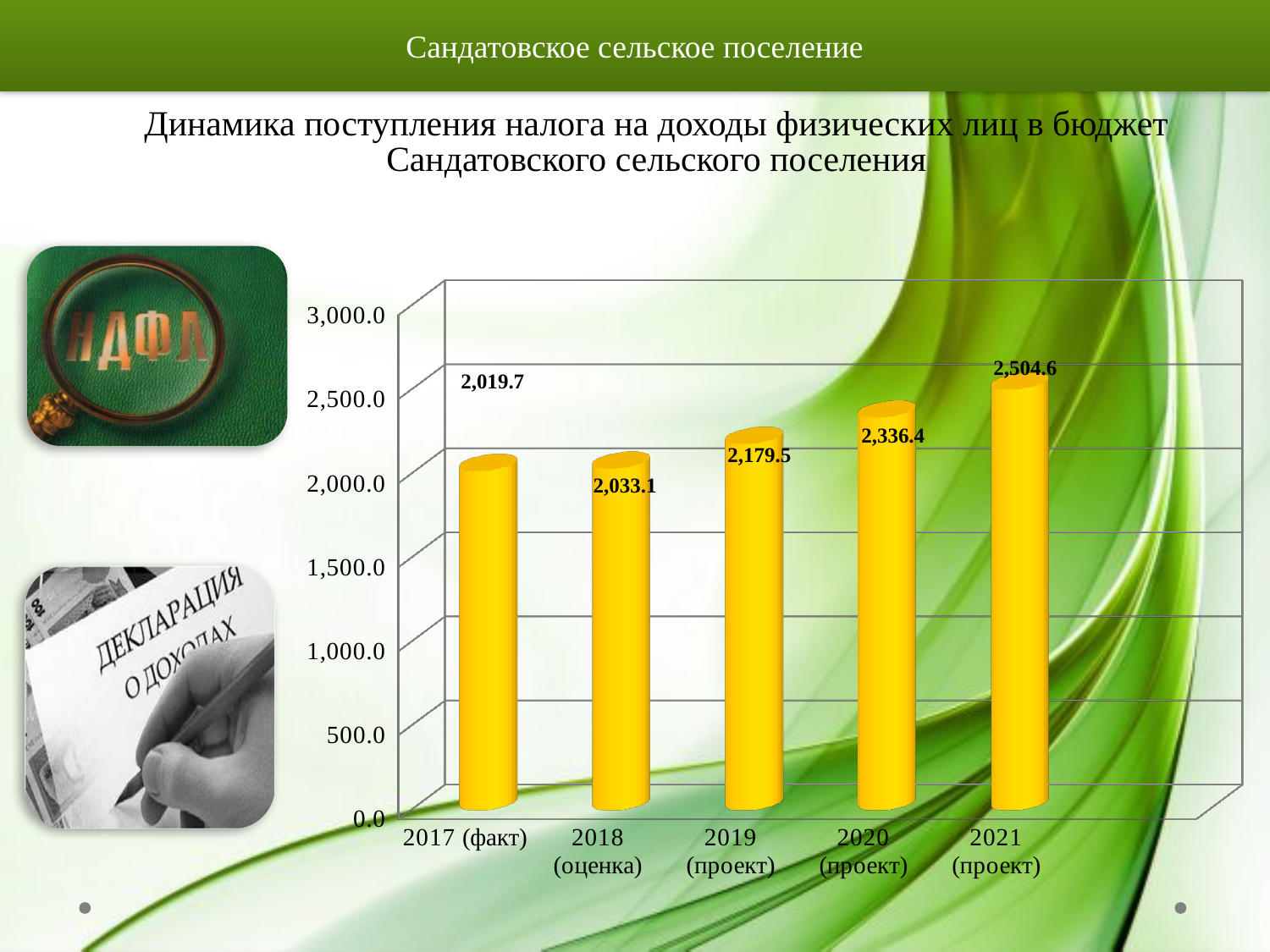
Do the values rise or fall from 2017 to 2021? rise Is the value for 2021 (проект) greater or less than 2,500.0? greater What is the difference between the values for 2020 (проект) and 2019 (проект)? 156.9 What is the value for 2017 (факт)? 2,019.7 How many years are shown on the x axis? 5 What is the value for 2019 (проект)? 2,179.5 What is the value for 2021 (проект)? 2,504.6 Which is larger, the value for 2020 (проект) or the value for 2018 (оценка)? 2020 (проект) What kind of chart is shown on the slide? bar chart Which year has the highest value? 2021 (проект) Which year has the lowest value? 2017 (факт) What is the difference between the values for 2021 (проект) and 2017 (факт)? 484.9